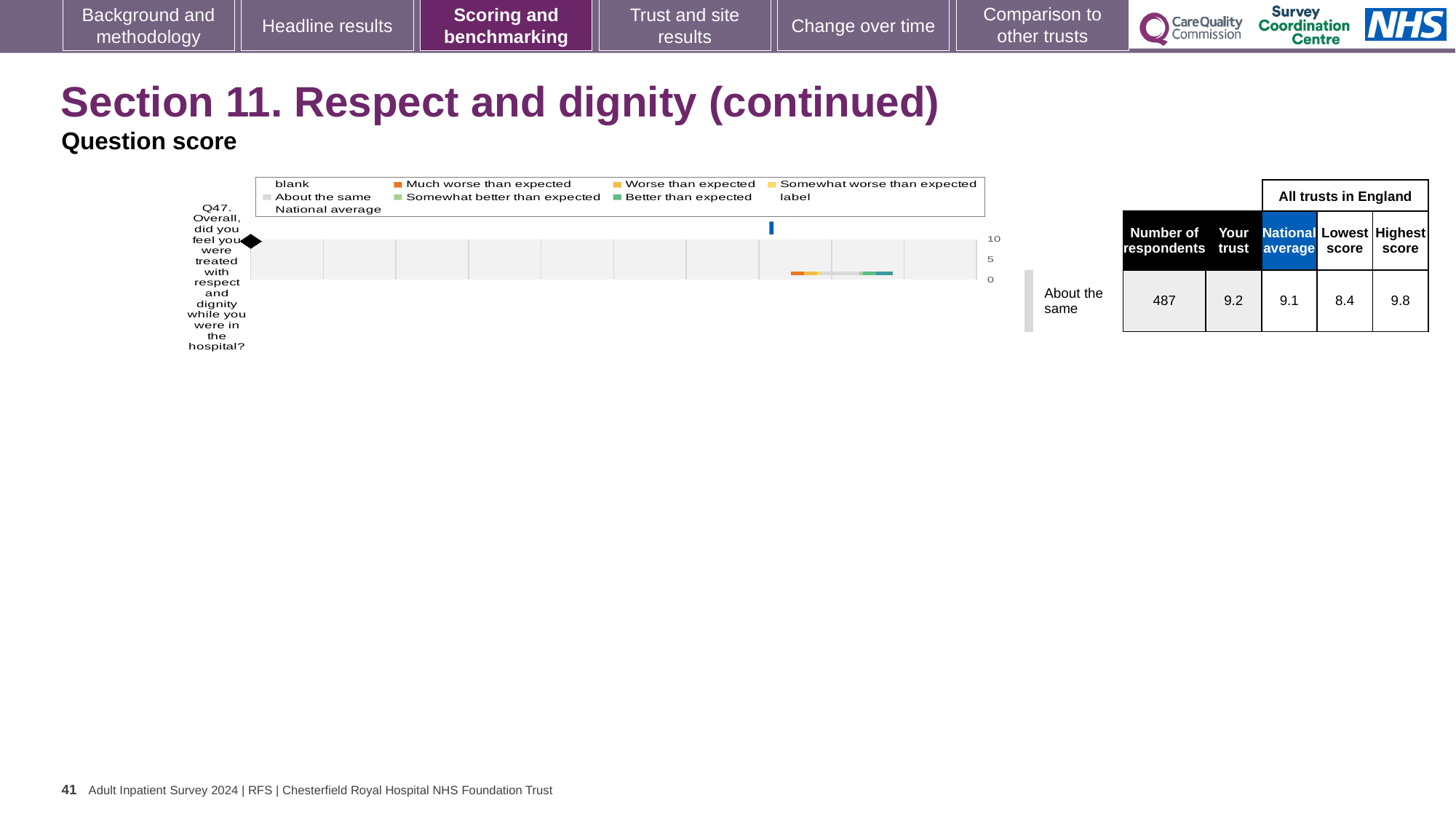
In the table beside the chart, how many respondents answered Q47? 487 In the table beside the chart, what is the National average score for Q47? 9.1 What is the highest tick value shown on the chart's score axis? 10 For Q47, which is larger: the 'Your trust' score or the National average? Your trust For Q47, what is the difference between the Highest score and the Lowest score among all trusts in England? 1.4 Which survey question is plotted on the chart? Q47. Overall, did you feel you were treated with respect and dignity while you were in the hospital? In the table beside the chart, what is the 'Your trust' score for Q47? 9.2 How many entries does the chart legend list? 9 How many survey questions are plotted on the chart? 1 In the table beside the chart, what is the Lowest score among all trusts in England for Q47? 8.4 What kind of chart is shown on the slide? bar chart In the table beside the chart, what is the Highest score among all trusts in England for Q47? 9.8